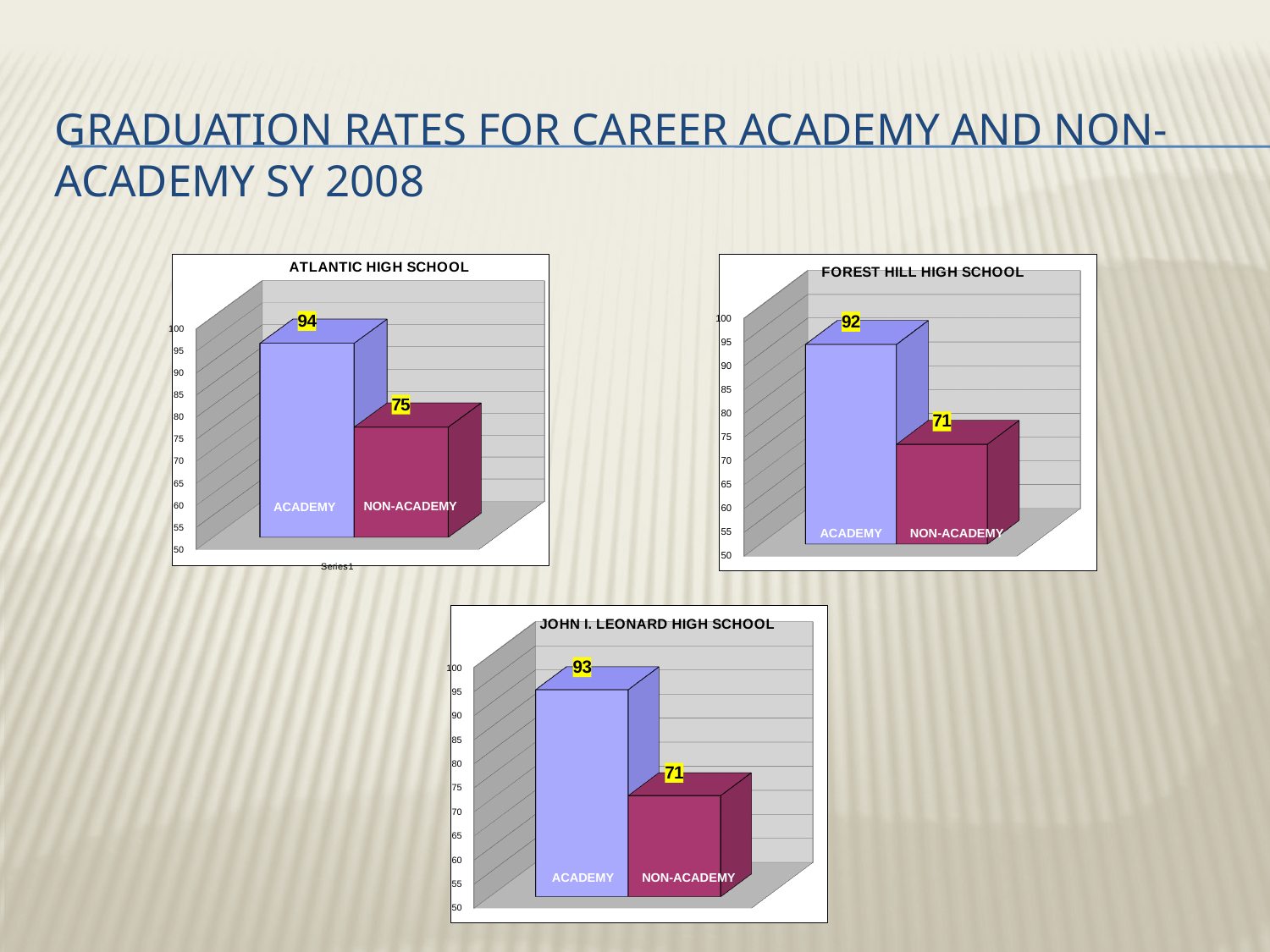
In the Atlantic High School chart, what is the difference between the Academy and Non-Academy values? 19 In the Atlantic High School chart, what is the graduation rate for Non-Academy? 75 In the John I. Leonard High School chart, what is the value for Academy? 93 In the Atlantic High School chart, what is the graduation rate for Academy? 94 In the John I. Leonard High School chart, which is larger, the Academy value or the Non-Academy value? Academy In the Forest Hill High School chart, what is the value for Academy? 92 In the Forest Hill High School chart, which category has the lower value? Non-Academy In the John I. Leonard High School chart, what is the difference between the Academy and Non-Academy values? 22 In the Forest Hill High School chart, what is the value for Non-Academy? 71 How many charts are shown on the slide? 3 In the John I. Leonard High School chart, what is the value for Non-Academy? 71 What kind of chart is the Forest Hill High School chart? Bar chart